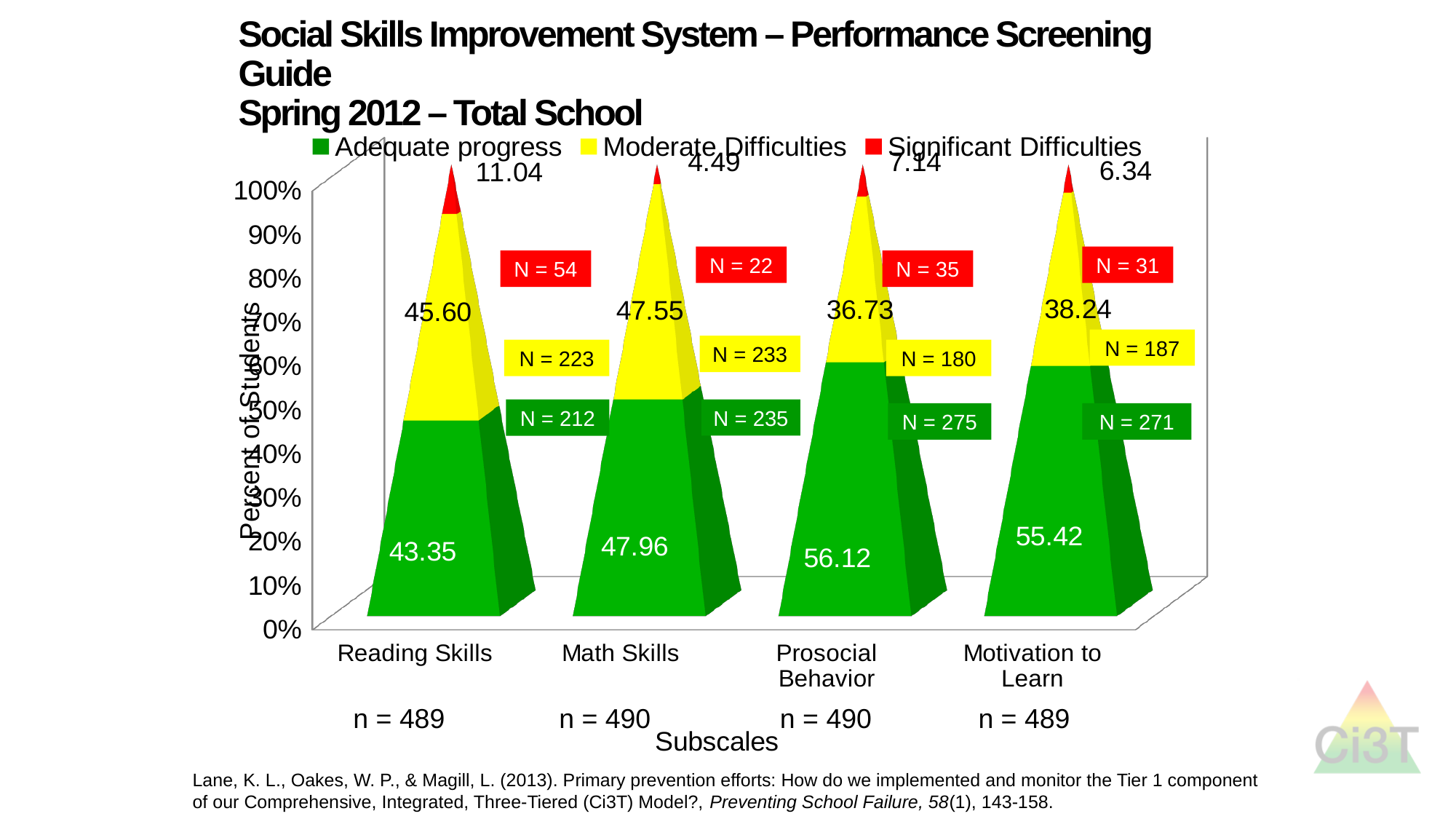
How many subscales are shown on the x axis? 4 Which subscale has the highest Adequate progress value? Prosocial Behavior Which subscale has the lowest Significant Difficulties value? Math Skills What colour represents Significant Difficulties in the legend? Red Which subscale has the highest Significant Difficulties value? Reading Skills What is the Moderate Difficulties value for Math Skills? 47.55 What is the Moderate Difficulties value for Motivation to Learn? 38.24 What is the Adequate progress value for Prosocial Behavior? 56.12 What is the Significant Difficulties value for Reading Skills? 11.04 How many series does the legend list? 3 What is the difference between the Adequate progress values for Prosocial Behavior and Reading Skills? 12.77 Which has the larger Moderate Difficulties value, Reading Skills or Motivation to Learn? Reading Skills